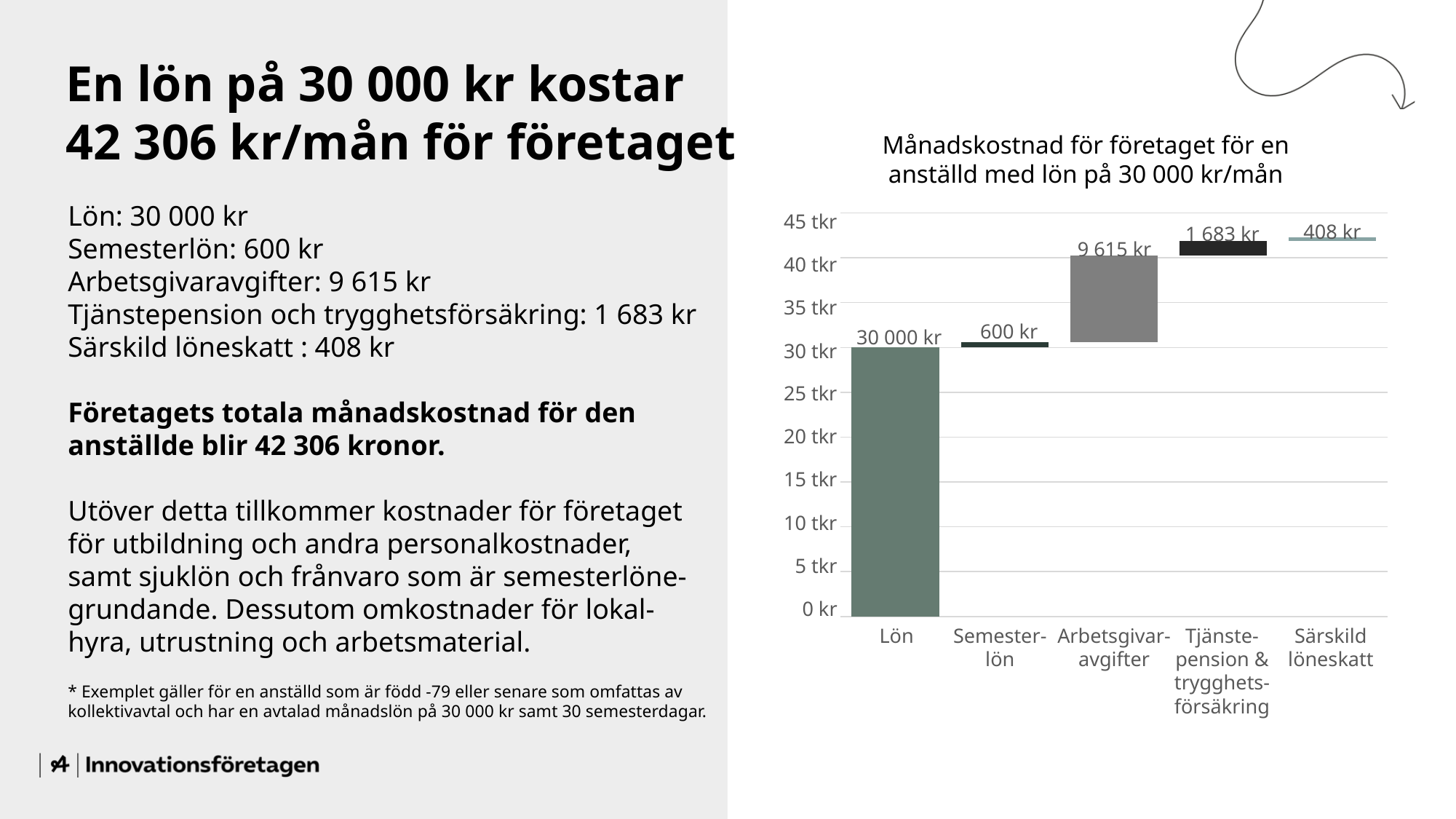
What is the difference between the values for Arbetsgivaravgifter and Tjänstepension & trygghetsförsäkring? 7 932 kr Which category has the highest value in the chart? Lön What is the value shown for Tjänstepension & trygghetsförsäkring in the chart? 1 683 kr How many categories are shown on the x axis of the chart? 5 What kind of chart is shown on the slide? Bar chart (waterfall) Which category has the lowest value in the chart? Särskild löneskatt What is the value shown for Särskild löneskatt in the chart? 408 kr Which is larger, the value for Semesterlön or the value for Särskild löneskatt? Semesterlön What is the value shown for Arbetsgivaravgifter in the chart? 9 615 kr What is the value shown for Lön in the chart? 30 000 kr What is the title of the chart? Månadskostnad för företaget för en anställd med lön på 30 000 kr/mån What is the value shown for Semesterlön in the chart? 600 kr